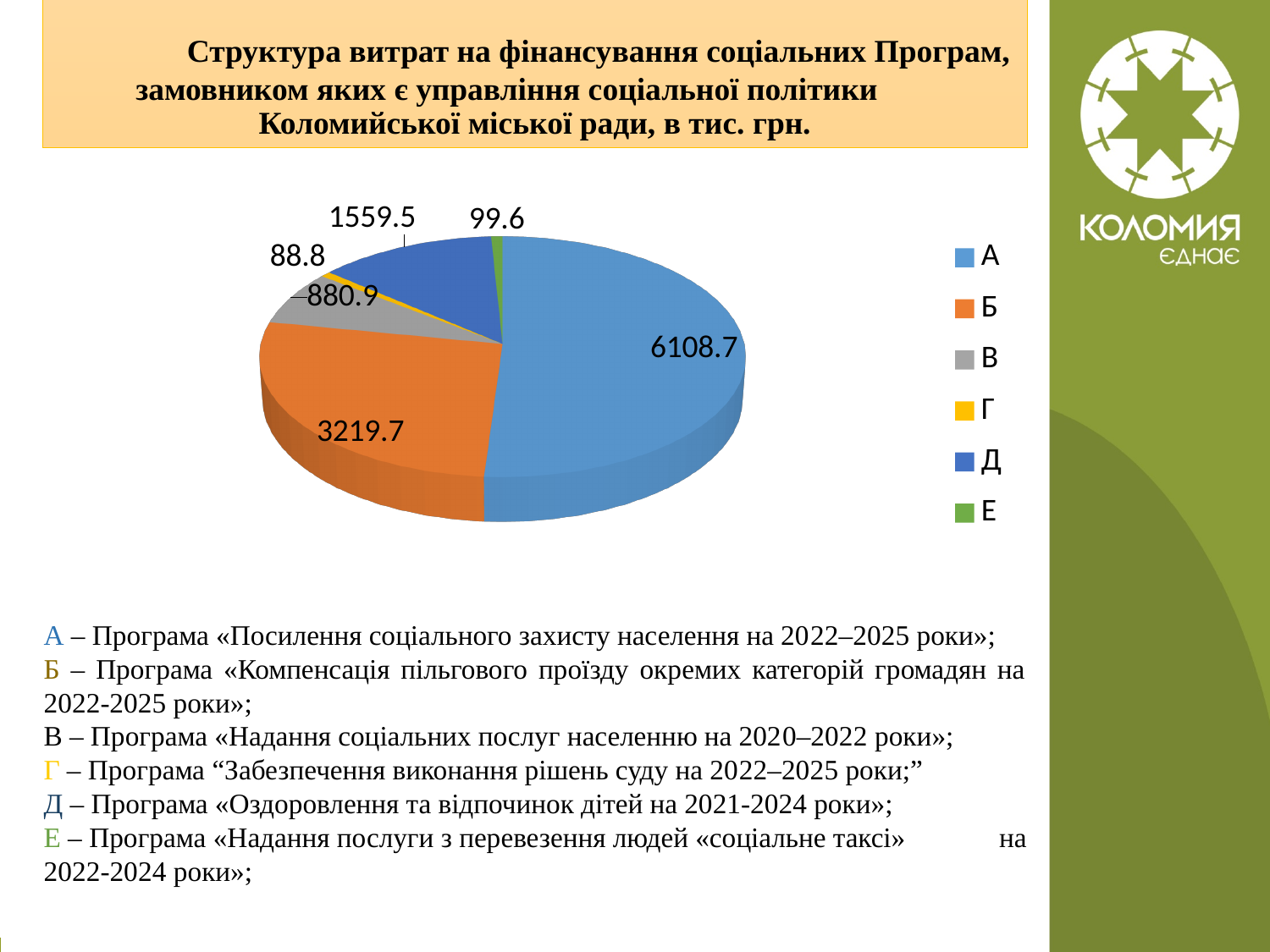
Which is larger, the value for В or the value for Е? В What is the difference between the values for Д and В? 678.6 What colour is the slice for category Б in the pie chart? orange How many categories does the pie chart show? 6 What kind of chart is shown on the slide? pie chart Which category has the smallest slice in the pie chart? Г What is the value for category А in the pie chart? 6108.7 What is the difference between the values for А and Б? 2889.0 What is the value for category Д in the pie chart? 1559.5 What is the value for category Г in the pie chart? 88.8 What is the value for category Б in the pie chart? 3219.7 Which category has the largest slice in the pie chart? А